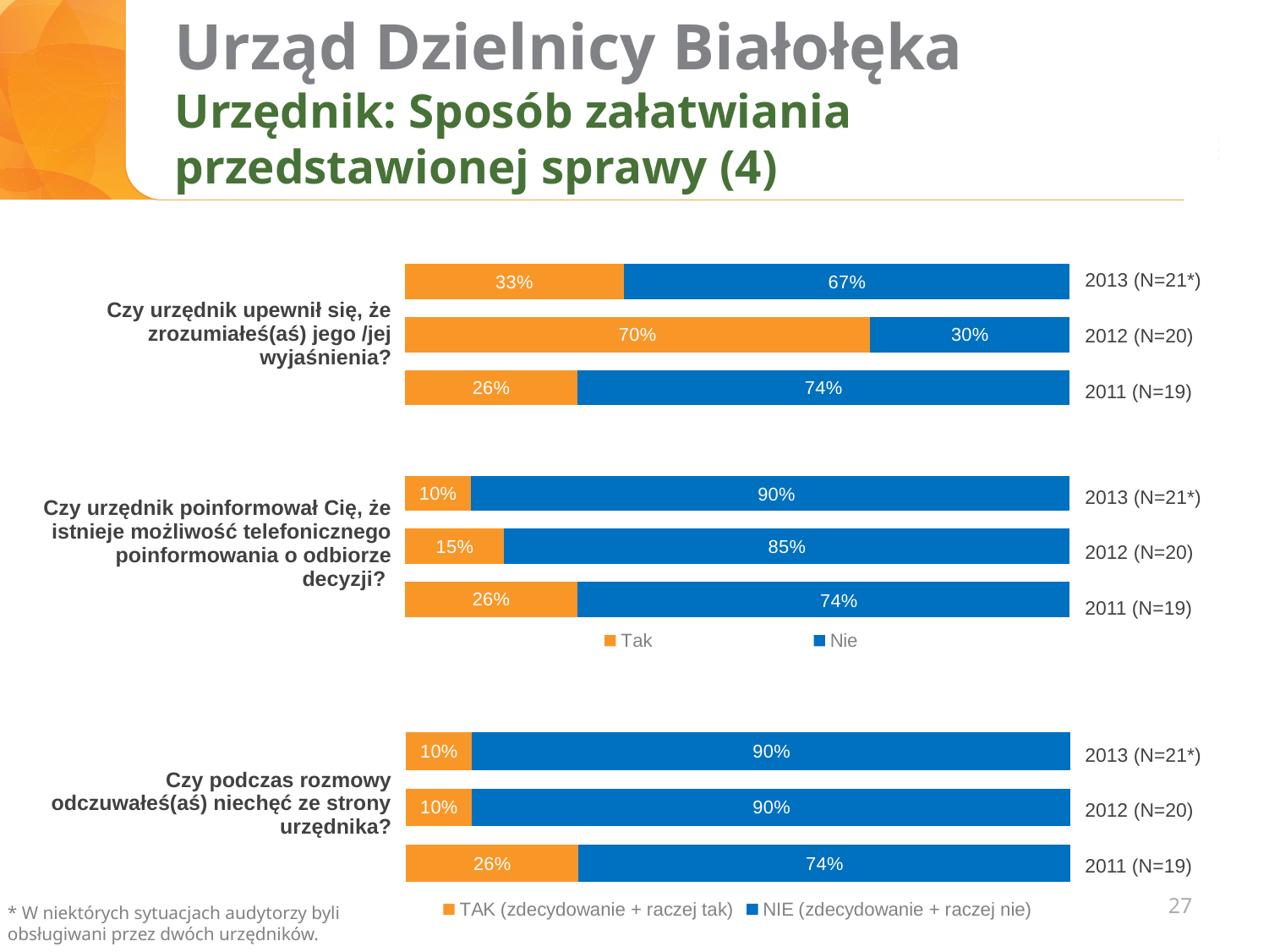
In the bottom chart ("Czy podczas rozmowy odczuwałeś(aś) niechęć ze strony urzędnika?"), what is the NIE value for 2011 (N=19)? 74% In the top chart ("Czy urzędnik upewnił się, że zrozumiałeś(aś) jego /jej wyjaśnienia?"), which year has the highest Tak share? 2012 (N=20) In the middle chart ("Czy urzędnik poinformował Cię, że istnieje możliwość telefonicznego poinformowania o odbiorze decyzji?"), what is the Tak value for 2012 (N=20)? 15% In the middle chart ("Czy urzędnik poinformował Cię, że istnieje możliwość telefonicznego poinformowania o odbiorze decyzji?"), is the Nie value for 2011 (N=19) larger or smaller than the Nie value for 2013 (N=21*)? smaller In the bottom chart ("Czy podczas rozmowy odczuwałeś(aś) niechęć ze strony urzędnika?"), what is the total of the 2013 (N=21*) stacked bar? 100% In the top chart ("Czy urzędnik upewnił się, że zrozumiałeś(aś) jego /jej wyjaśnienia?"), what is the Tak value for 2012 (N=20)? 70% What type of chart is used for the top chart ("Czy urzędnik upewnił się, że zrozumiałeś(aś) jego /jej wyjaśnienia?")? Stacked bar chart How many year bars does the bottom chart ("Czy podczas rozmowy odczuwałeś(aś) niechęć ze strony urzędnika?") show? 3 In the top chart ("Czy urzędnik upewnił się, że zrozumiałeś(aś) jego /jej wyjaśnienia?"), what is the Nie value for 2013 (N=21*)? 67% In the top chart ("Czy urzędnik upewnił się, że zrozumiałeś(aś) jego /jej wyjaśnienia?"), what is the difference between the Tak values for 2012 (N=20) and 2013 (N=21*)? 37 percentage points In the middle chart ("Czy urzędnik poinformował Cię, że istnieje możliwość telefonicznego poinformowania o odbiorze decyzji?"), which year has the lowest Tak share? 2013 (N=21*) How many series does the legend of the bottom chart list? 2